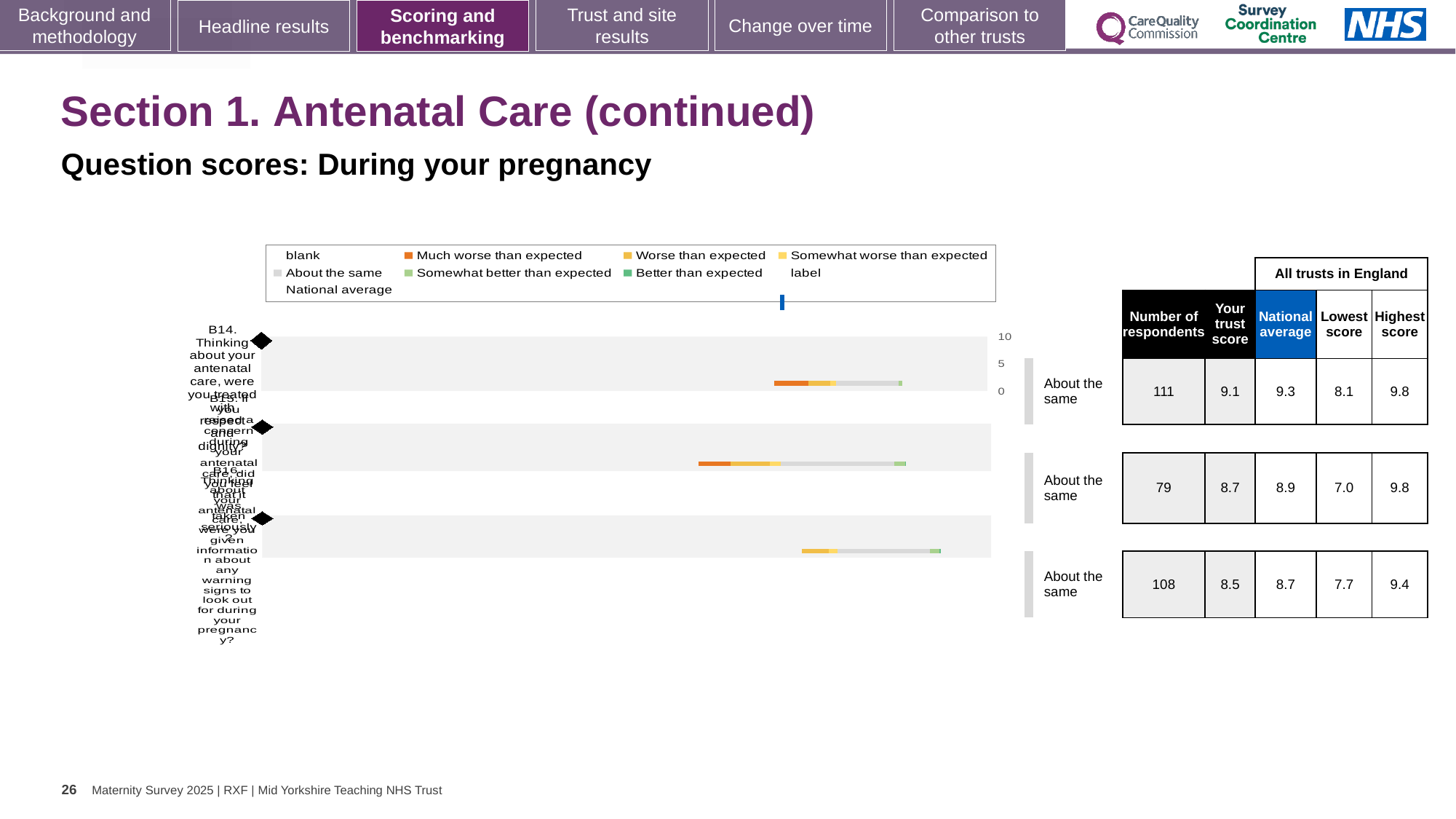
What is the lowest score for the third row? 7.7 Which row has the highest 'Your trust score'? The first row (B14), 9.1 Which row has the lowest value in the 'Lowest score' column? The second row, 7.0 What is the 'Your trust score' for the first row (B14)? 9.1 Is the highest score larger for the first row or the third row? The first row (9.8 vs 9.4) How many question rows (bars) are plotted in the chart? 3 How many of the three rows are rated 'About the same'? 3 What is the number of respondents for the first row (B14, treated with respect and dignity)? 111 For the first row (B14), how much higher is the national average than the trust score? 0.2 What benchmark rating is shown for the third row? About the same What kind of chart is shown on the slide? bar chart What is the national average for the second row? 8.9